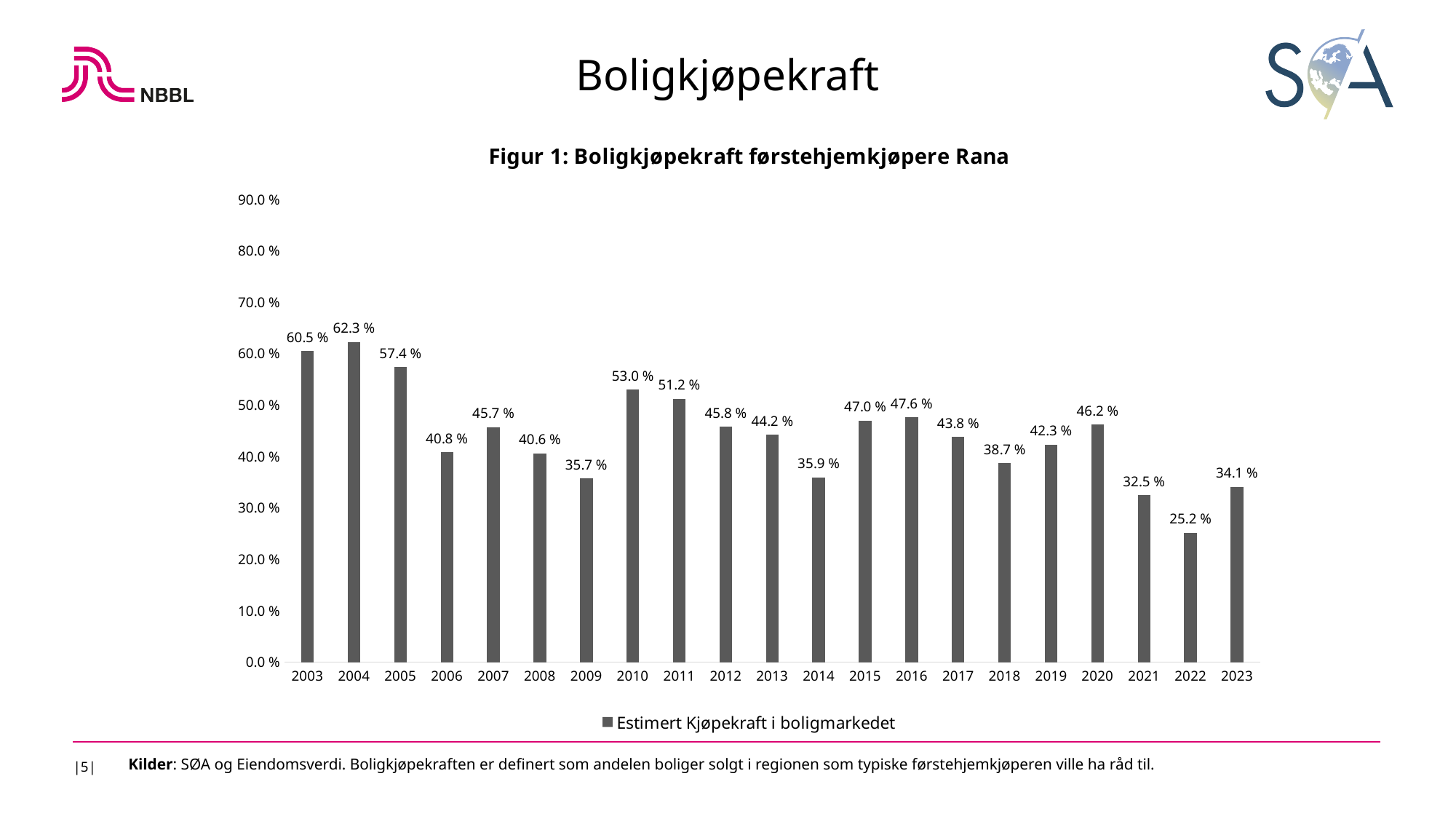
What is the value for 2016? 47.6 % How many series does the legend list? 1 What is the value for 2010? 53.0 % How many years are shown on the x axis? 21 Which is larger, the value for 2011 or the value for 2020? 2011 What is the value for 2022? 25.2 % What is the title of the chart? Figur 1: Boligkjøpekraft førstehjemkjøpere Rana Is the value for 2009 greater or less than 40.0 %? less What is the difference between the values for 2003 and 2023? 26.4 % Which year has the highest value? 2004 Which year has the lowest value? 2022 What kind of chart is shown? bar chart